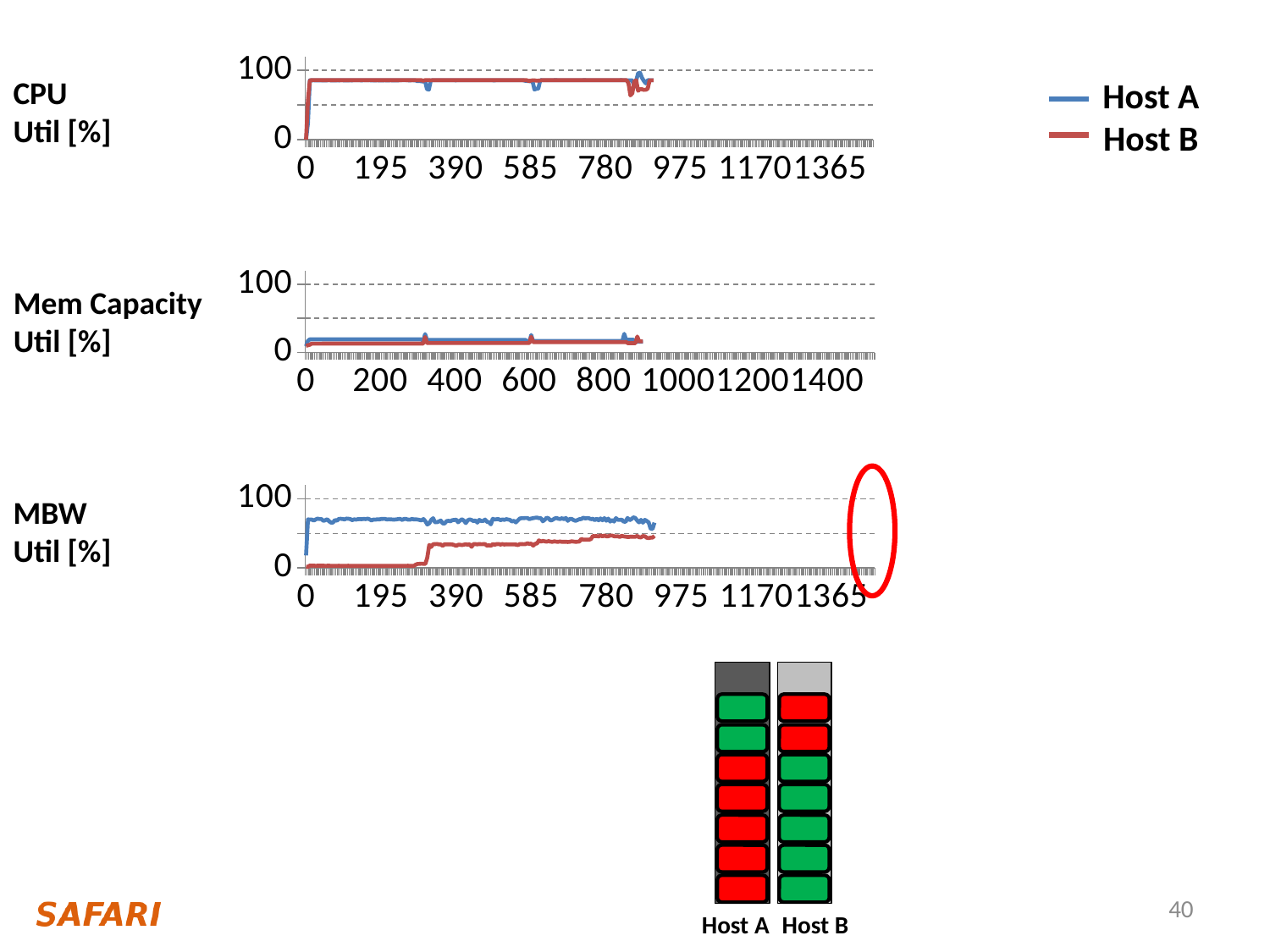
In the CPU Util [%] chart, is the value for Host A at x = 195 greater or less than 50? greater In the MBW Util [%] chart, is the value for Host B at x = 195 greater or less than 50? less In the MBW Util [%] chart, does the Host B line generally rise or fall along the x axis? rise In the Mem Capacity Util [%] chart, is the value for Host B at x = 800 greater or less than 50? less Which series is drawn in blue in the charts? Host A How many line charts are shown on the slide? 3 Which series is drawn in red in the charts? Host B What kind of chart is the CPU Util [%] chart? line chart In the MBW Util [%] chart, which host has the higher value at x = 585? Host A How many series does the legend list for the charts? 2